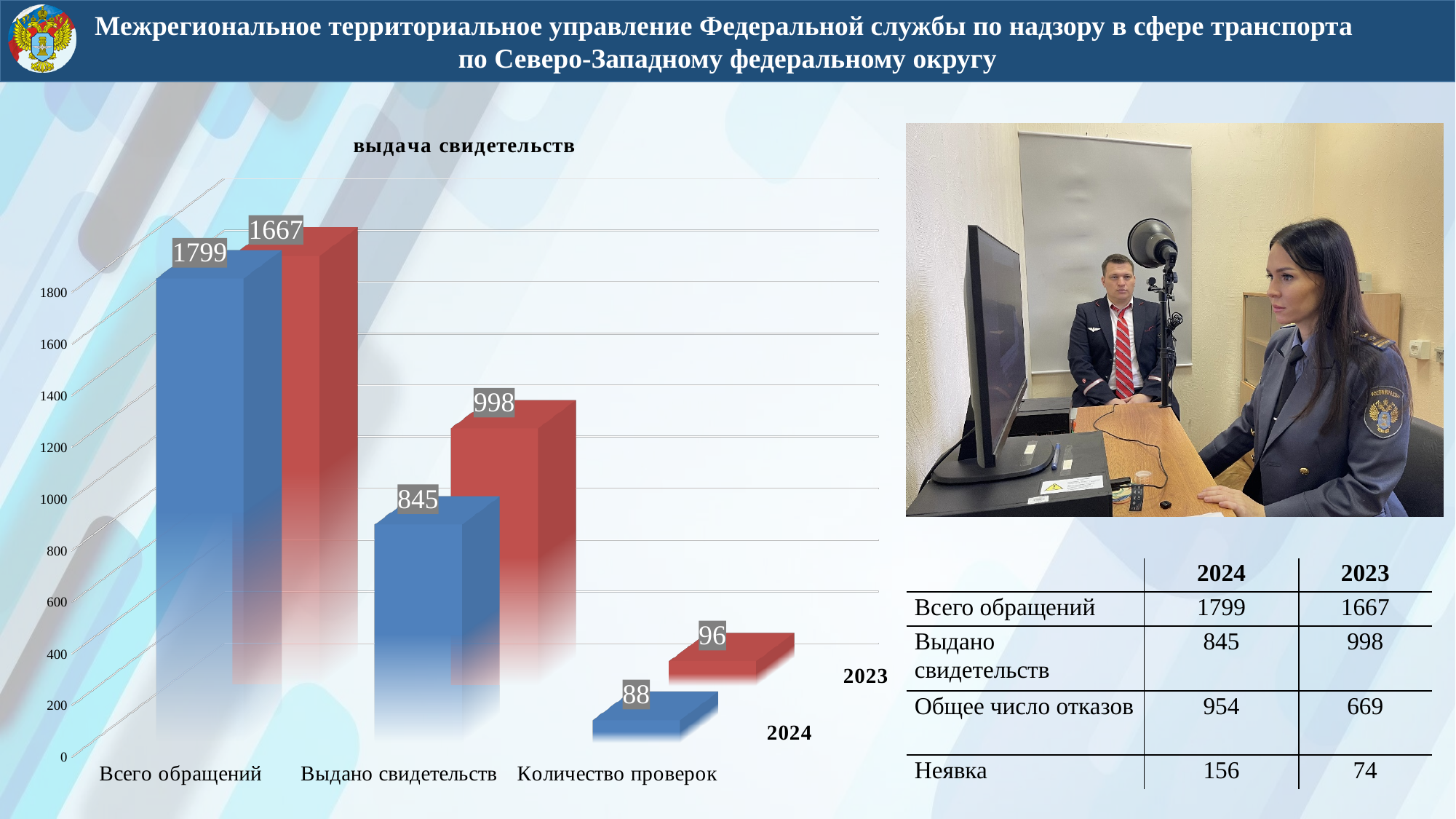
What kind of chart is shown on the slide? bar chart What is the difference between the 2023 and 2024 values for Выдано свидетельств? 153 What is the title of the chart? выдача свидетельств What is the value for Выдано свидетельств in the 2023 series? 998 What is the difference between the 2024 and 2023 values for Всего обращений? 132 What is the value for Всего обращений in the 2024 series? 1799 How many series does the chart show? 2 For Выдано свидетельств, which series has the larger value, 2024 or 2023? 2023 Which category has the highest value in the 2023 series? Всего обращений How many categories are shown on the x axis of the chart? 3 What is the value for Количество проверок in the 2024 series? 88 Which category has the lowest value in the 2024 series? Количество проверок